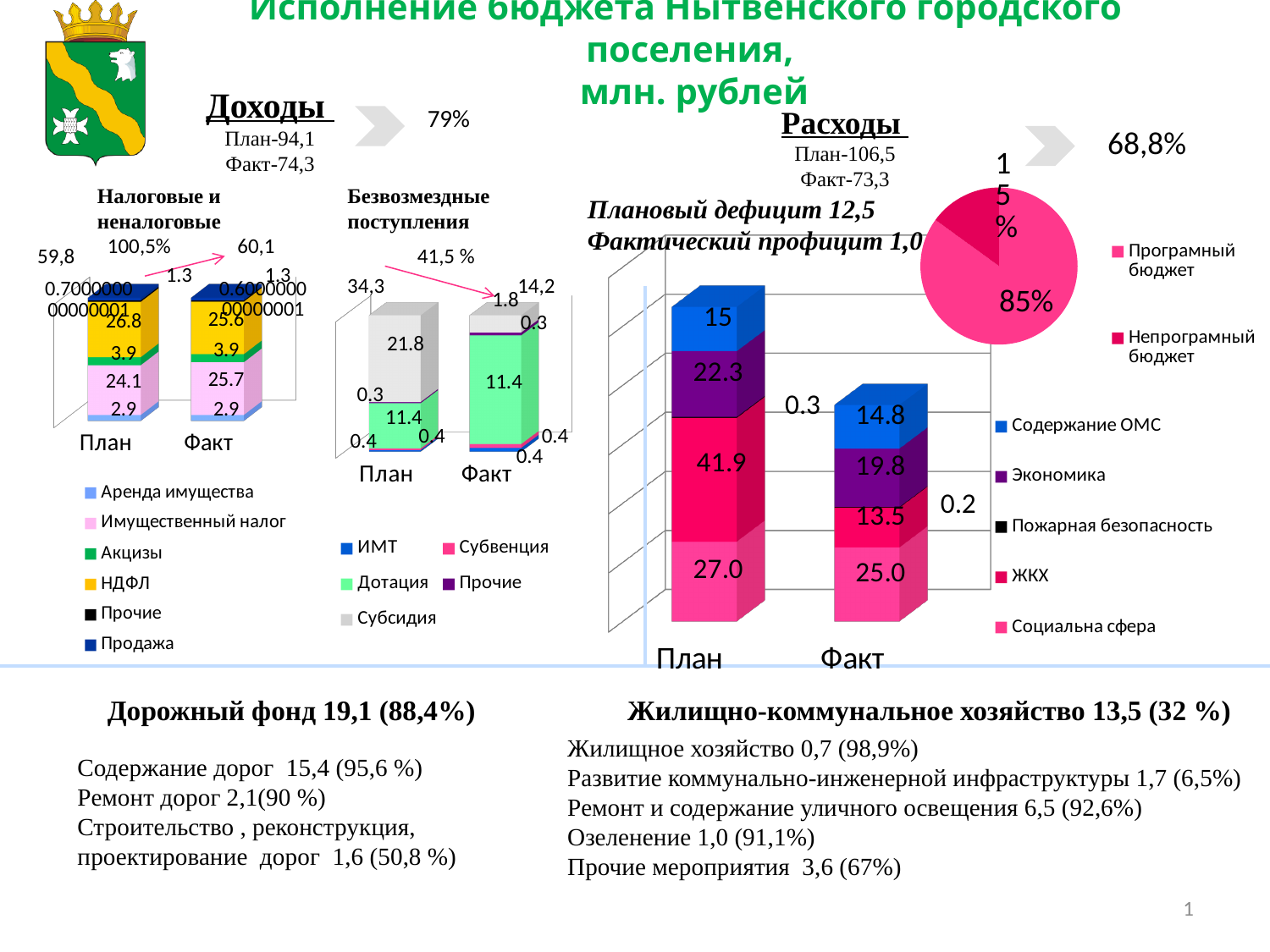
In the Расходы chart, what is the value of ЖКХ for План? 41.9 What kind of chart shows Програмный бюджет and Непрограмный бюджет? pie chart How many series does the legend of the Безвозмездные поступления chart list? 5 How many series does the legend of the Налоговые и неналоговые chart list? 6 In the Расходы chart, what is the value of Содержание ОМС for Факт? 14.8 In the Расходы chart, which segment is the largest in the План bar? ЖКХ In the Безвозмездные поступления chart, what is the value of Субсидия for План? 21.8 In the pie chart, what share does Програмный бюджет have? 85% In the Расходы chart, what is the value of ЖКХ for Факт? 13.5 In the Налоговые и неналоговые chart, what is the value of Имущественный налог for Факт? 25.7 In the Расходы chart, is Социальна сфера larger for План or for Факт? План In the Расходы chart, what is the difference between the ЖКХ values for План and Факт? 28.4